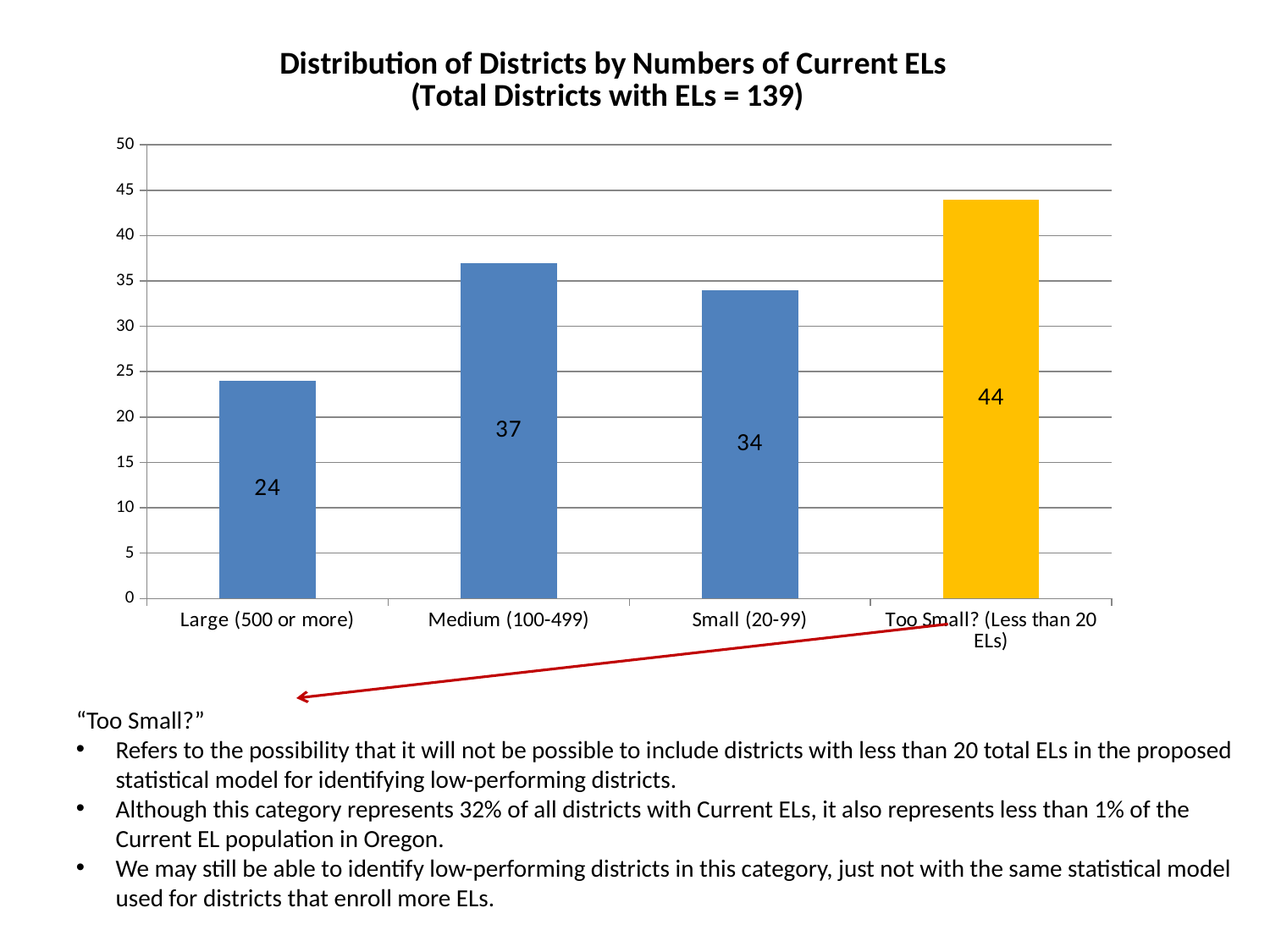
What kind of chart is shown on the slide? bar chart What is the value for Too Small? (Less than 20 ELs)? 44 What is the difference between the values for Too Small? (Less than 20 ELs) and Large (500 or more)? 20 What is the value for Small (20-99)? 34 What is the value for Large (500 or more)? 24 What is the title of the chart? Distribution of Districts by Numbers of Current ELs (Total Districts with ELs = 139) Is the value for Medium (100-499) greater or less than 35? greater What is the value for Medium (100-499)? 37 Which category has the highest value? Too Small? (Less than 20 ELs) Which is larger, the value for Medium (100-499) or the value for Small (20-99)? Medium (100-499) How many categories are shown on the x axis? 4 Which category has the lowest value? Large (500 or more)